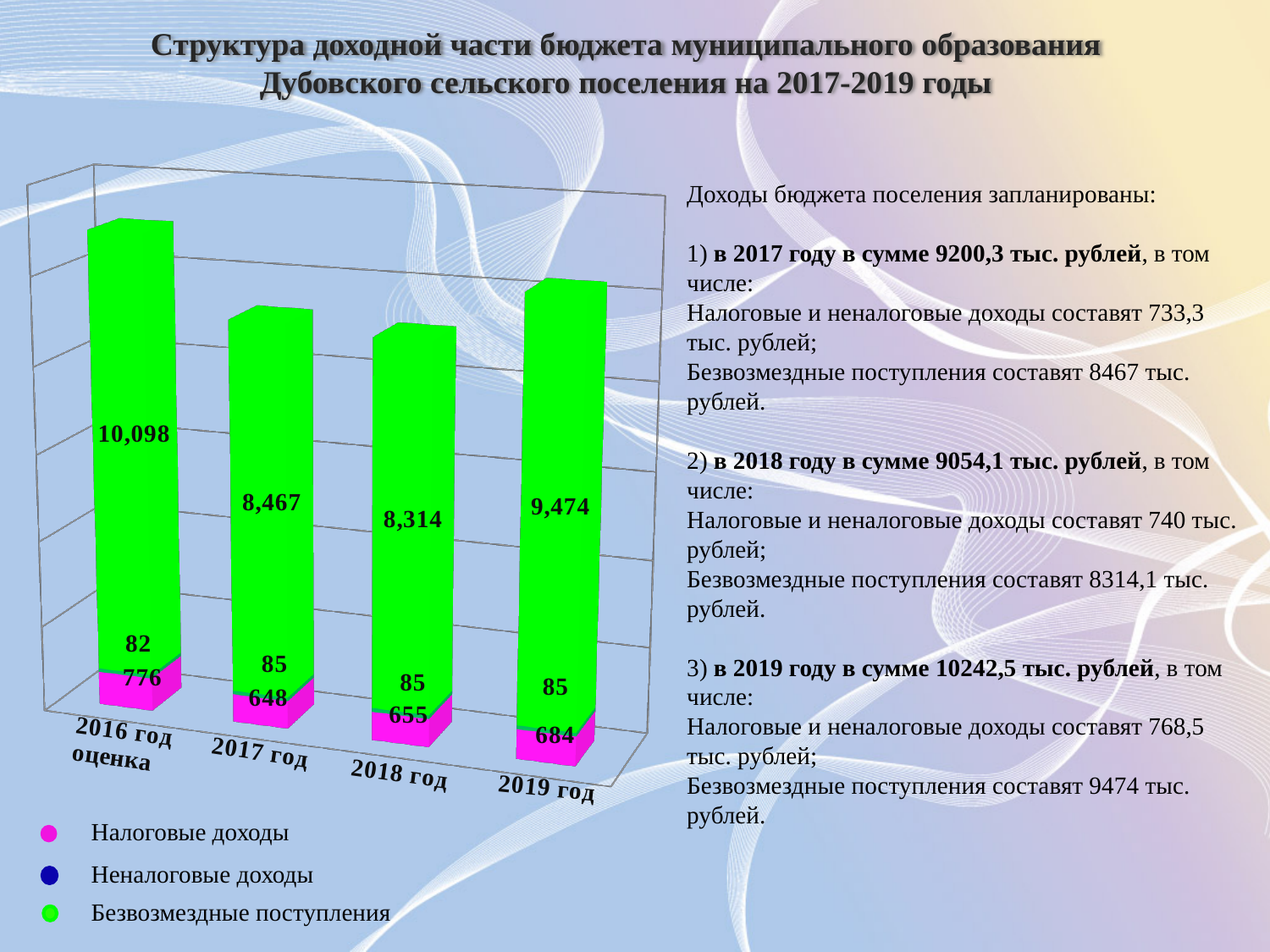
How many series does the chart legend list? 3 What is the difference between Безвозмездные поступления in 2019 год and 2018 год? 1,160 What is the value of Налоговые доходы for 2016 год оценка? 776 How many year categories are shown on the chart's x axis? 4 What is the value of Неналоговые доходы for 2019 год? 85 What type of chart is shown on the slide? stacked bar chart Which year has the highest value of Безвозмездные поступления? 2016 год оценка What is the value of Налоговые доходы for 2018 год? 655 Which year has the lowest value of Налоговые доходы? 2017 год What is the total of the stacked bar for 2017 год? 9,200 What is the value of Безвозмездные поступления for 2017 год? 8,467 Is Безвозмездные поступления larger in 2017 год or in 2019 год? 2019 год